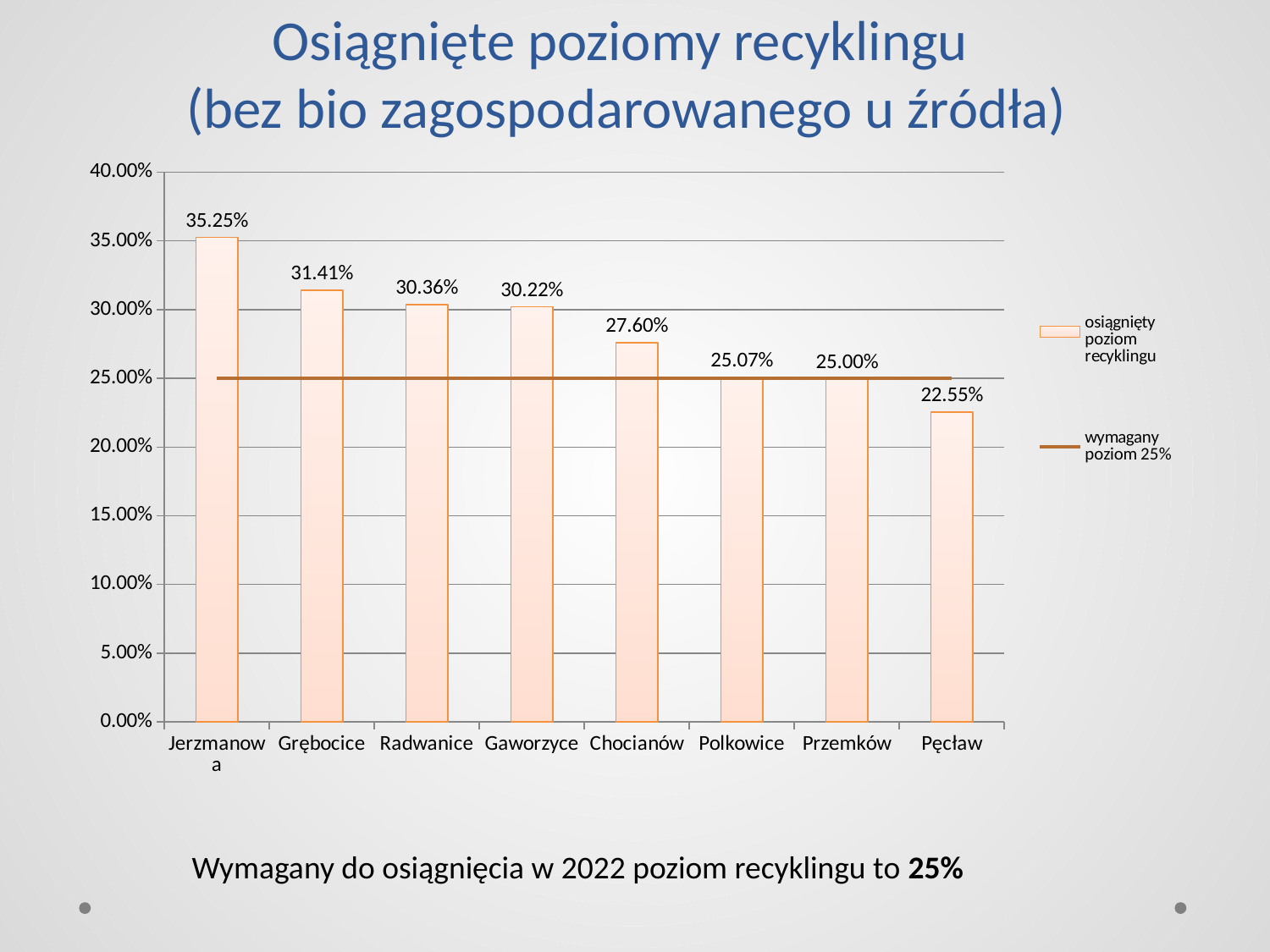
What is the achieved recycling level for Jerzmanowa? 35.25% How many municipalities are shown on the x axis? 8 What is the difference between the recycling levels of Jerzmanowa and Grębocice? 3.84% Which has a higher recycling level, Radwanice or Chocianów? Radwanice What kind of chart is shown on the slide? bar chart Which municipality has the highest achieved recycling level? Jerzmanowa Which municipality has the lowest achieved recycling level? Pęcław How many entries does the legend list? 2 What is the achieved recycling level for Pęcław? 22.55% Is the value for Pęcław greater or less than 25.00%? less What is the achieved recycling level for Chocianów? 27.60% What level does the horizontal line labelled 'wymagany poziom' mark? 25%